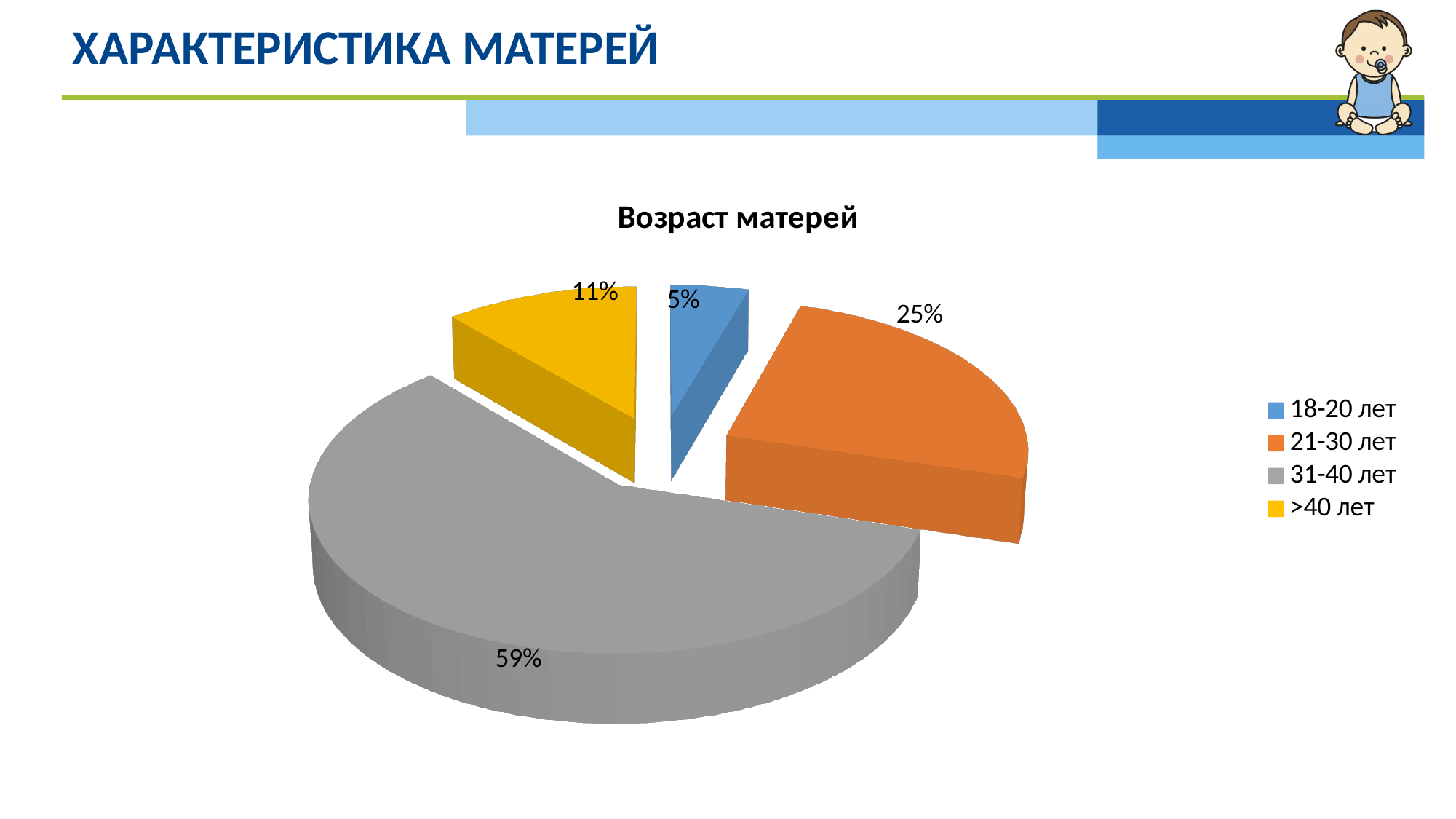
What is the difference in percentage points between the 31-40 лет slice and the 21-30 лет slice? 34 What share of the pie is the >40 лет slice? 11% What type of chart is shown on the slide? pie chart What share of the pie is the 18-20 лет slice? 5% What share of the pie is the 31-40 лет slice? 59% What colour is the 21-30 лет slice? orange Which age group has the largest share of the pie? 31-40 лет Which slice is larger: >40 лет or 18-20 лет? >40 лет Which age group has the smallest share of the pie? 18-20 лет What is the title of the chart? Возраст матерей How many slices does the pie chart have? 4